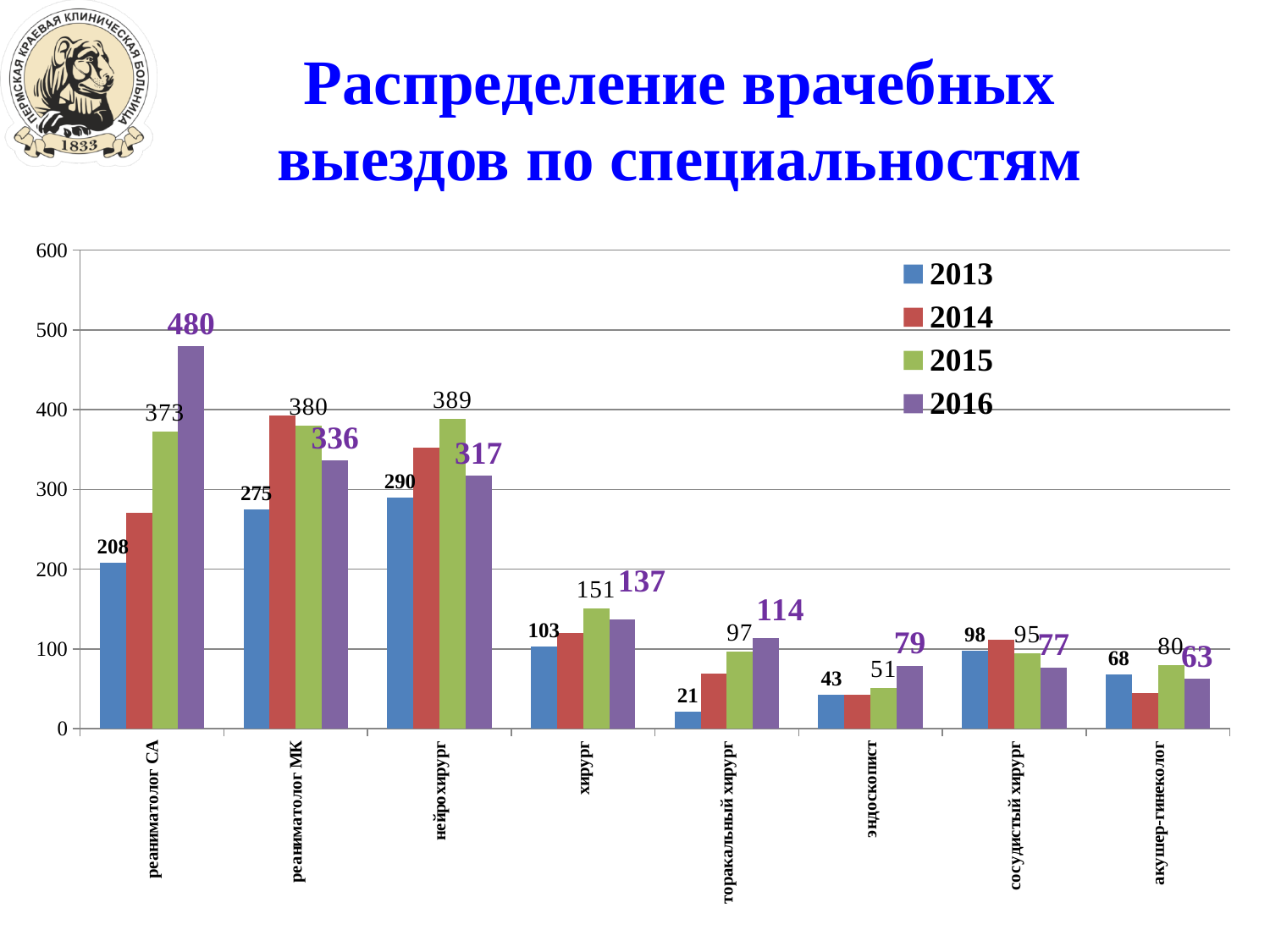
What is the value for 2013 for торакальный хирург? 21 How many series does the legend list? 4 How many specialties are shown on the x axis? 8 What kind of chart is shown on the slide? bar chart Which specialty has the highest value for 2016? реаниматолог СА What is the difference between the 2016 and 2013 values for реаниматолог СА? 272 Do the values for реаниматолог СА rise or fall from 2013 to 2016? rise For хирург, which year has the larger value, 2015 or 2016? 2015 What is the value for 2016 for реаниматолог СА? 480 Which specialty has the lowest value for 2013? торакальный хирург What is the value for 2015 for нейрохирург? 389 Is the value for 2014 for реаниматолог МК greater or less than 300? greater